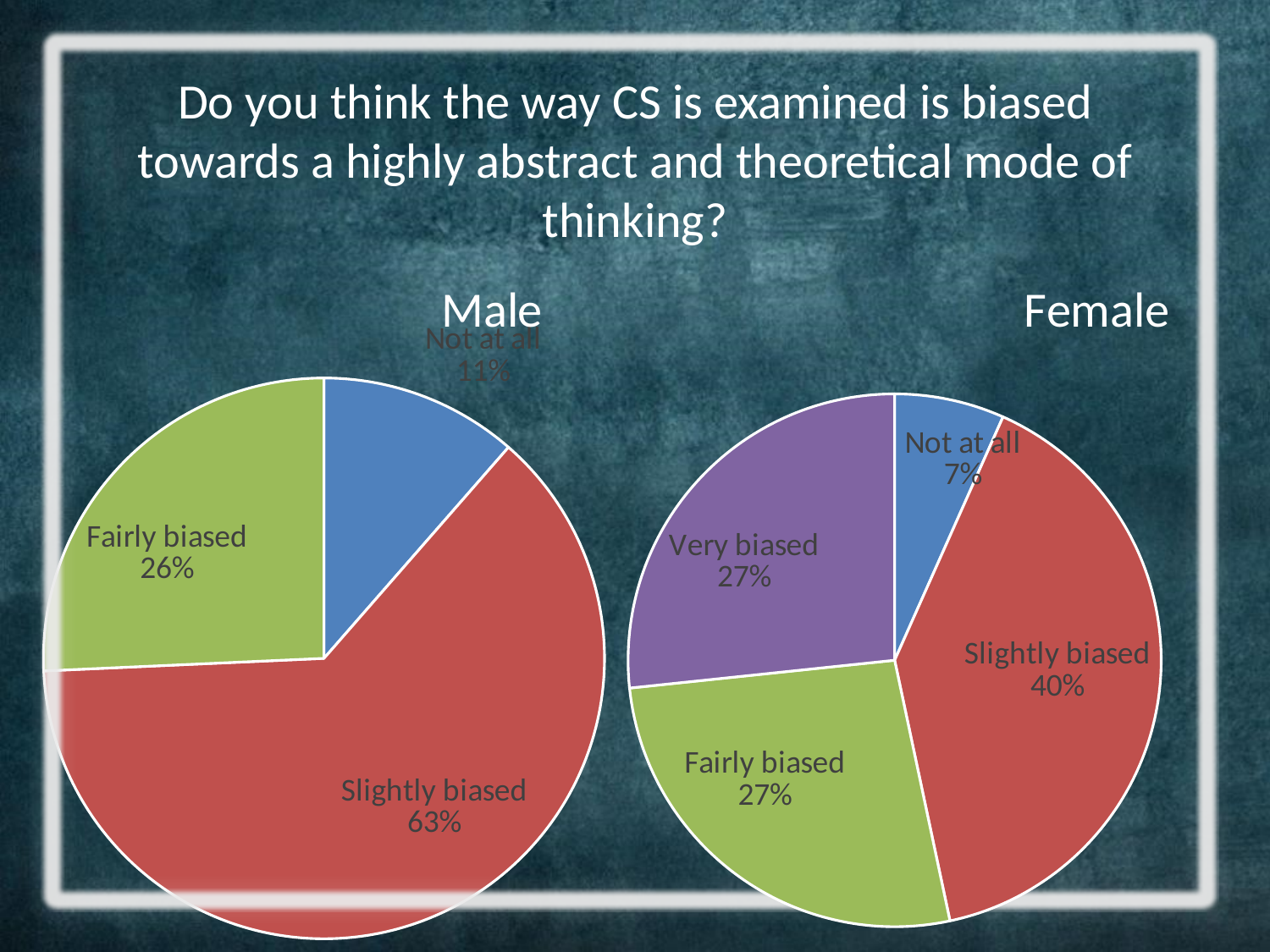
How many slices does the Male chart have? 3 In the Female chart, what share of respondents answered "Slightly biased"? 40% In the Male chart, which response has the largest slice? Slightly biased In the Female chart, what share of respondents answered "Very biased"? 27% In the Male chart, what share of respondents answered "Slightly biased"? 63% How many slices does the Female chart have? 4 What type of chart is used for the Male and Female data? Pie chart In the Female chart, which response has the smallest slice? Not at all Which is larger: the "Slightly biased" share in the Male chart or in the Female chart? Male In the Female chart, what is the difference between the "Slightly biased" and "Fairly biased" shares? 13%